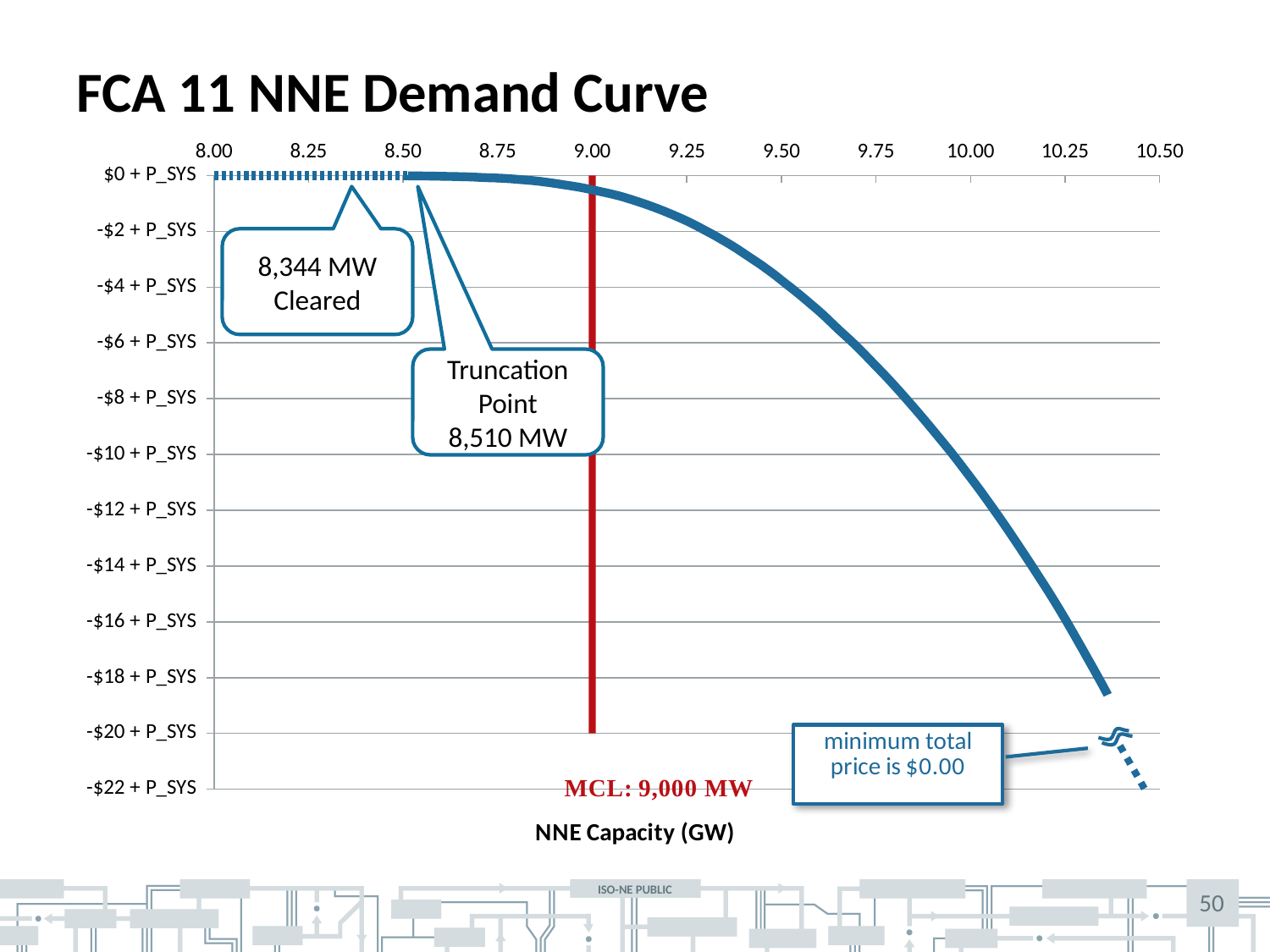
What is the title of the chart? FCA 11 NNE Demand Curve Does the demand curve rise or fall as NNE capacity increases beyond the truncation point? fall How many tick labels are shown on the x axis? 11 What kind of chart is shown on the slide? line chart What is the lowest label shown on the y axis? -$22 + P_SYS Is the price on the curve at 9.50 GW greater or less than -$10 + P_SYS? greater Is the price on the curve at 10.25 GW greater or less than -$10 + P_SYS? less How many MW are labelled as Cleared on the chart? 8,344 MW According to the callout, what is the minimum total price? $0.00 What is the label of the x axis? NNE Capacity (GW) What capacity is marked as the Truncation Point on the chart? 8,510 MW What MCL value is marked by the red vertical line? 9,000 MW